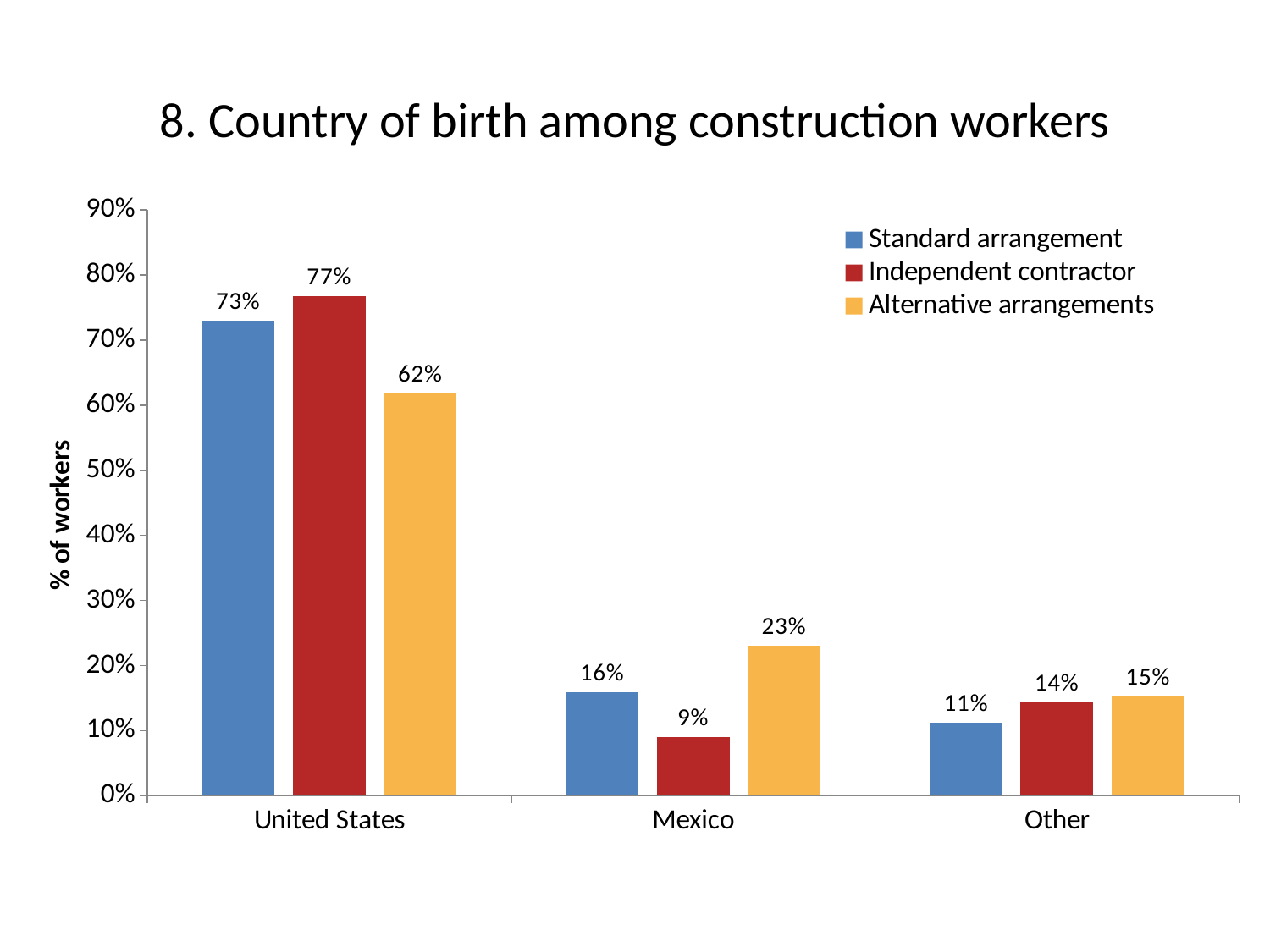
What percentage of workers in standard arrangements were born in the United States? 73% Is the Alternative arrangements value for the United States greater or less than 70%? less What percentage of workers in alternative arrangements were born in a country listed as Other? 15% What is the difference between the Alternative arrangements and Standard arrangement values for Mexico? 7% Which work arrangement has the lowest share of workers born in Mexico? Independent contractor What percentage of independent contractors were born in Mexico? 9% How many series does the legend list? 3 For the Other category, which is larger: the Standard arrangement value or the Independent contractor value? Independent contractor What is the label on the vertical axis? % of workers How many country-of-birth categories are shown on the x axis? 3 What kind of chart is shown on the slide? Bar chart Which work arrangement has the highest share of workers born in the United States? Independent contractor